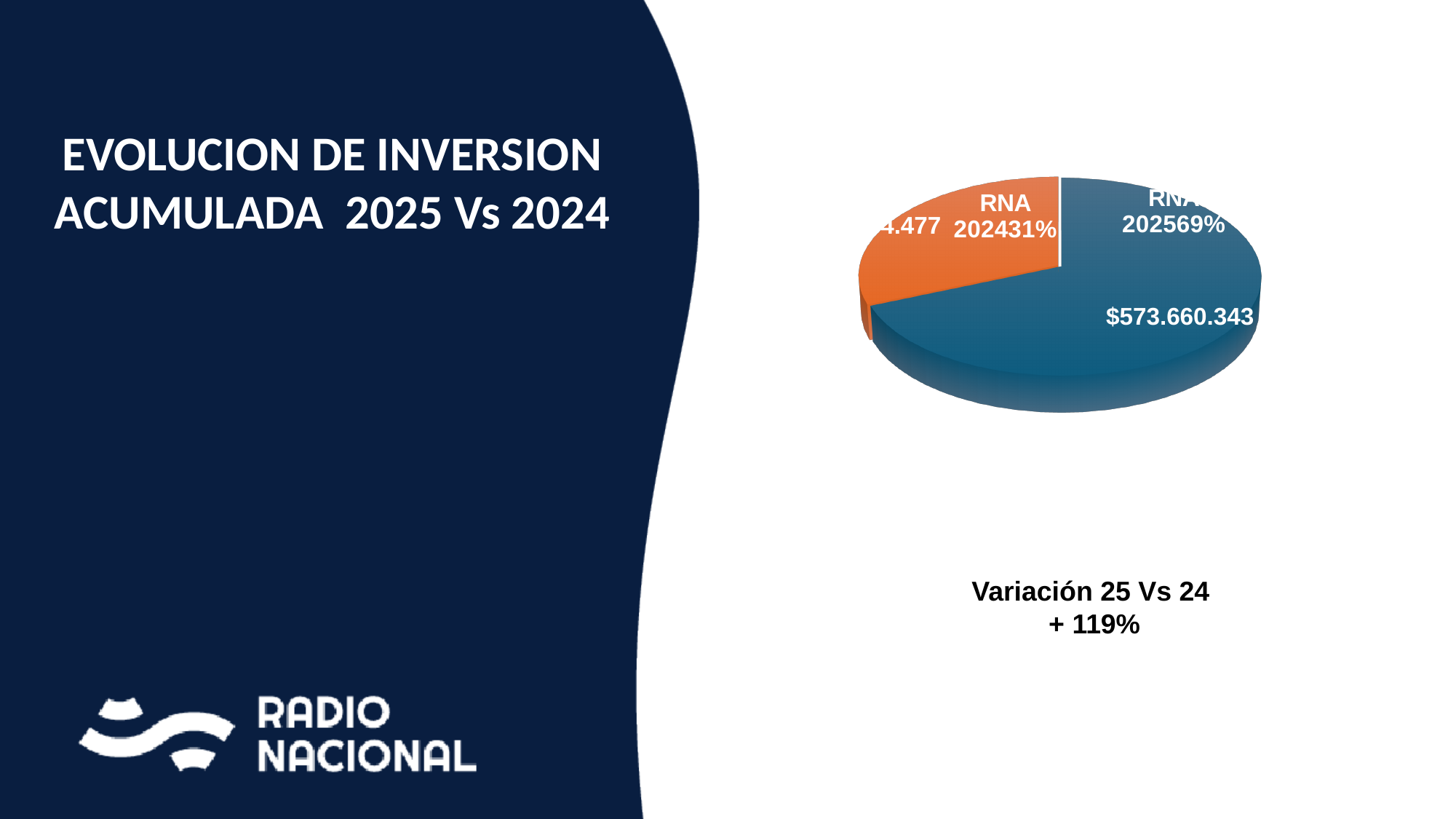
What share of the pie does RNA 2024 represent? 31% How many slices does the pie chart have? 2 Which is larger in the pie chart, RNA 2025 or RNA 2024? RNA 2025 What colour is the RNA 2025 slice of the pie chart? Blue What is the value shown for RNA 2025 in the pie chart? $573.660.343 Which slice of the pie chart is the smallest? RNA 2024 What variation between 2025 and 2024 is stated below the pie chart? + 119% By how many percentage points does the RNA 2025 share exceed the RNA 2024 share? 38 percentage points Which slice of the pie chart is the largest? RNA 2025 What share of the pie does RNA 2025 represent? 69% What kind of chart is shown on the slide? Pie chart